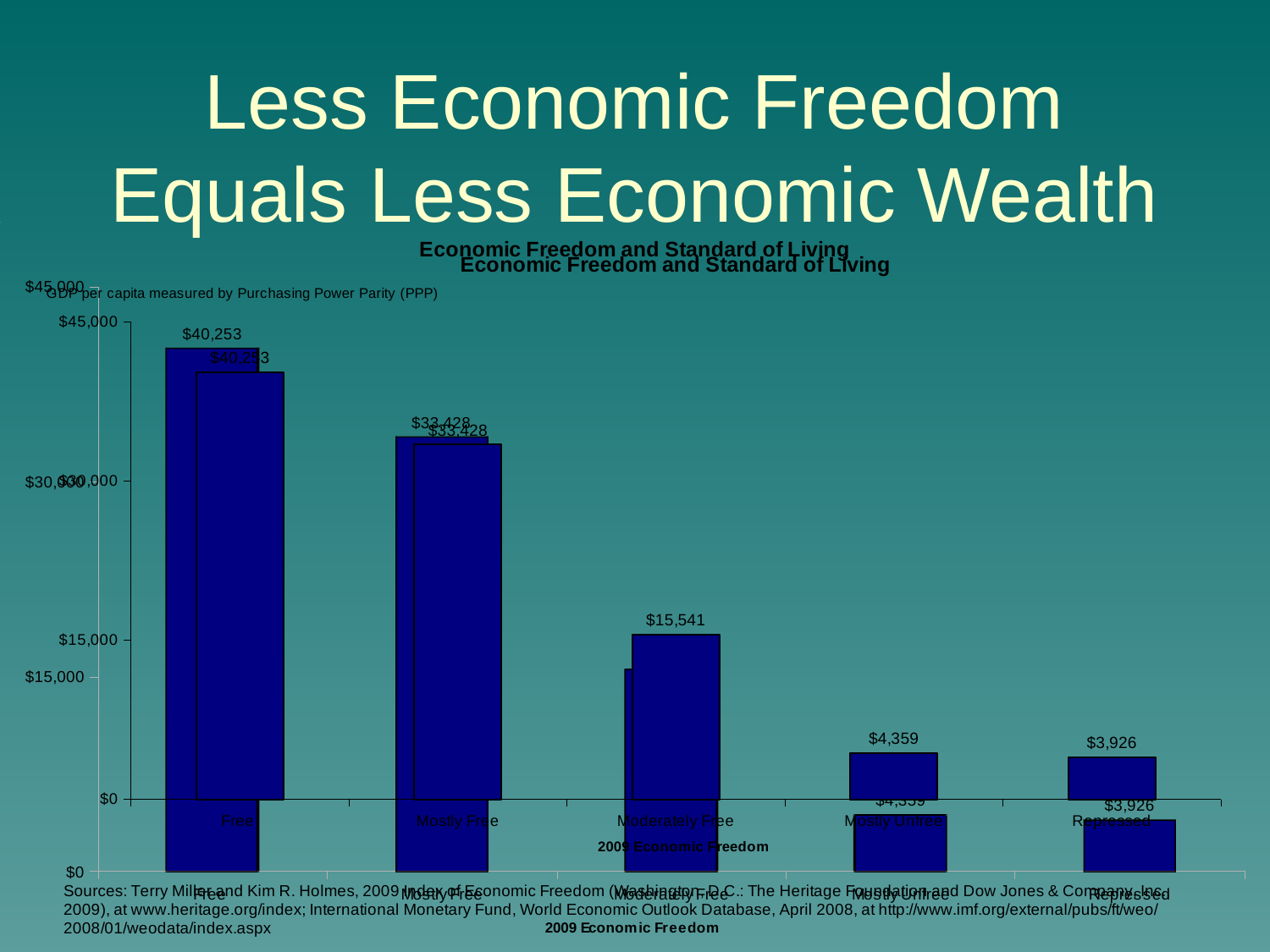
In the 'Economic Freedom and Standard of Living' chart, how many categories are shown on the x axis? 5 In the 'Economic Freedom and Standard of Living' chart, what is the value for Moderately Free? $15,541 In the 'Economic Freedom and Standard of Living' chart, what is the value for Repressed? $3,926 In the 'Economic Freedom and Standard of Living' chart, which is larger, the value for Mostly Free or the value for Moderately Free? Mostly Free In the 'Economic Freedom and Standard of Living' chart, what is the value for Mostly Free? $33,428 In the 'Economic Freedom and Standard of Living' chart, which category has the lowest value? Repressed In the 'Economic Freedom and Standard of Living' chart, which category has the highest value? Free What kind of chart is the 'Economic Freedom and Standard of Living' chart? Bar chart In the 'Economic Freedom and Standard of Living' chart, what is the difference between the Free and Mostly Free values? $6,825 In the 'Economic Freedom and Standard of Living' chart, do the values rise or fall from left to right along the x axis? Fall In the 'Economic Freedom and Standard of Living' chart, what is the value for the Free category? $40,253 In the 'Economic Freedom and Standard of Living' chart, what is the difference between the Mostly Unfree and Repressed values? $433